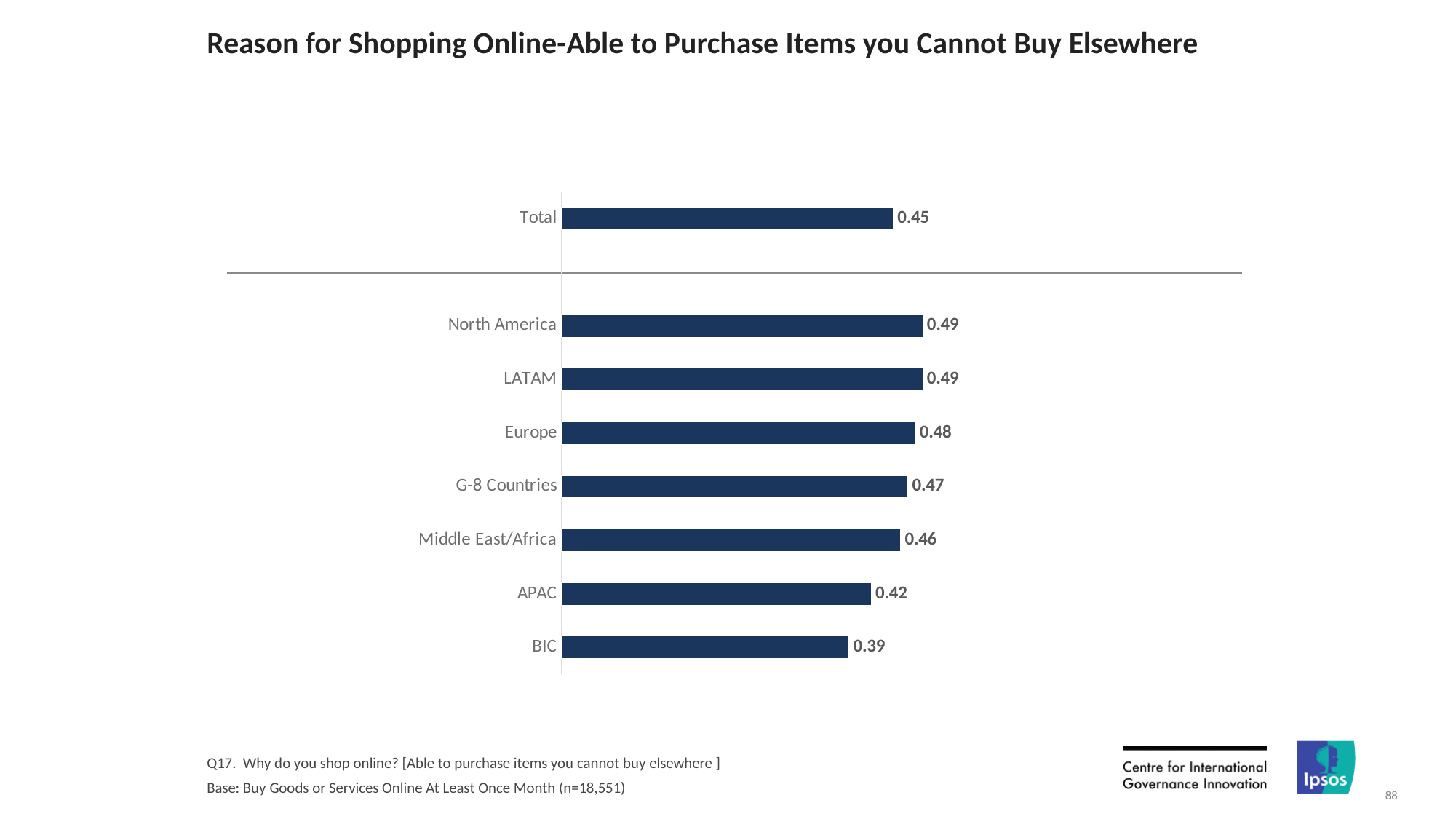
What is the value for Total? 0.45 What is the difference between the values for Total and BIC? 0.06 What is the title of the chart? Reason for Shopping Online-Able to Purchase Items you Cannot Buy Elsewhere What is the value for North America? 0.49 Which is larger, the value for Europe or the value for APAC? Europe How many bars are shown in the chart? 8 What is the value for Europe? 0.48 What kind of chart is shown on the slide? Bar chart What is the value for APAC? 0.42 What is the value for Middle East/Africa? 0.46 What is the difference between the values for North America and APAC? 0.07 Which category has the lowest value? BIC